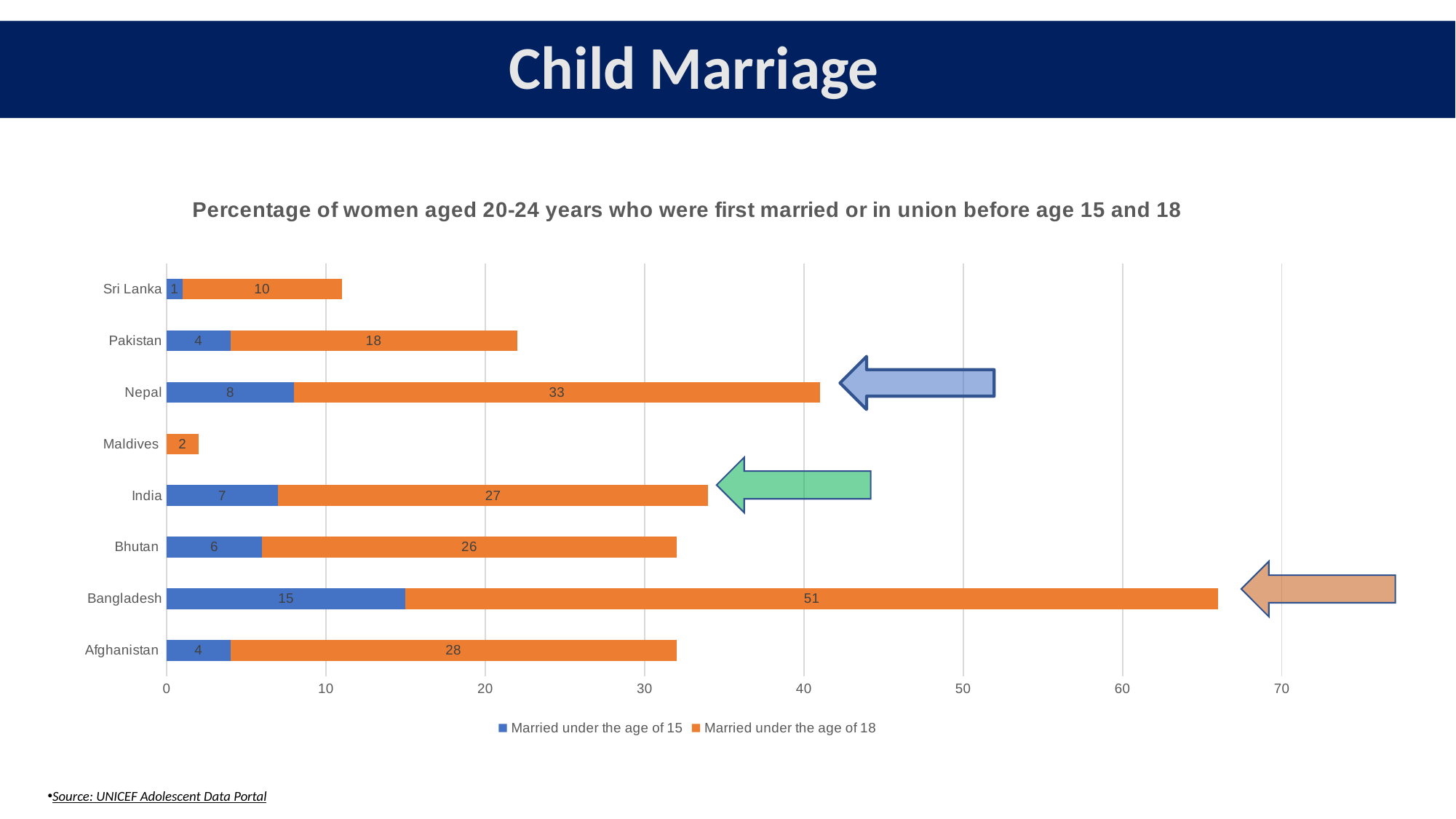
How many series does the legend list? 2 Which country has the lowest value for 'Married under the age of 18'? Maldives Which is larger: the 'Married under the age of 15' value for India or for Bhutan? India How many countries are shown on the chart? 8 What is the value for Nepal in the 'Married under the age of 15' series? 8 What is the value for Afghanistan in the 'Married under the age of 18' series? 28 What is the total of the stacked bar for Bangladesh? 66 Which country has the highest value for 'Married under the age of 18'? Bangladesh What kind of chart is shown on the slide? Stacked bar chart What is the difference between the 'Married under the age of 18' values for Bangladesh and Nepal? 18 What is the value for Bangladesh in the 'Married under the age of 18' series? 51 What is the total of the stacked bar for Nepal? 41